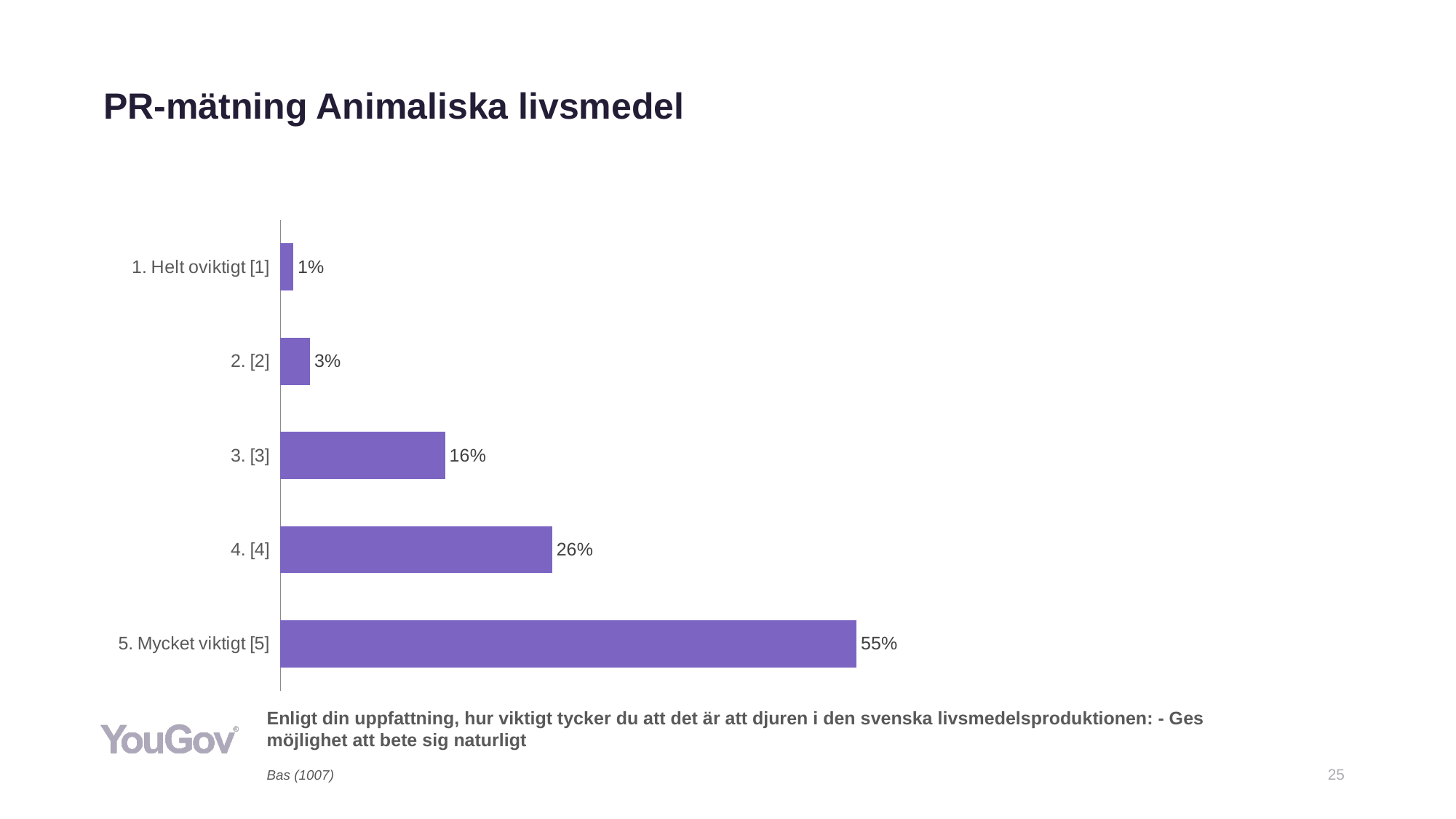
What is the value for "5. Mycket viktigt [5]"? 55% What is the difference between the values for "3. [3]" and "2. [2]"? 13% What kind of chart is shown on the slide? Bar chart Which is larger, the value for "4. [4]" or the value for "3. [3]"? 4. [4] What is the value for "1. Helt oviktigt [1]"? 1% Which category has the highest value? 5. Mycket viktigt [5] What is the value for "3. [3]"? 16% Which category has the lowest value? 1. Helt oviktigt [1] What is the base (Bas) sample size shown below the chart? 1007 How many categories are shown in the chart? 5 What is the value for "4. [4]"? 26% What is the difference between the values for "5. Mycket viktigt [5]" and "4. [4]"? 29%